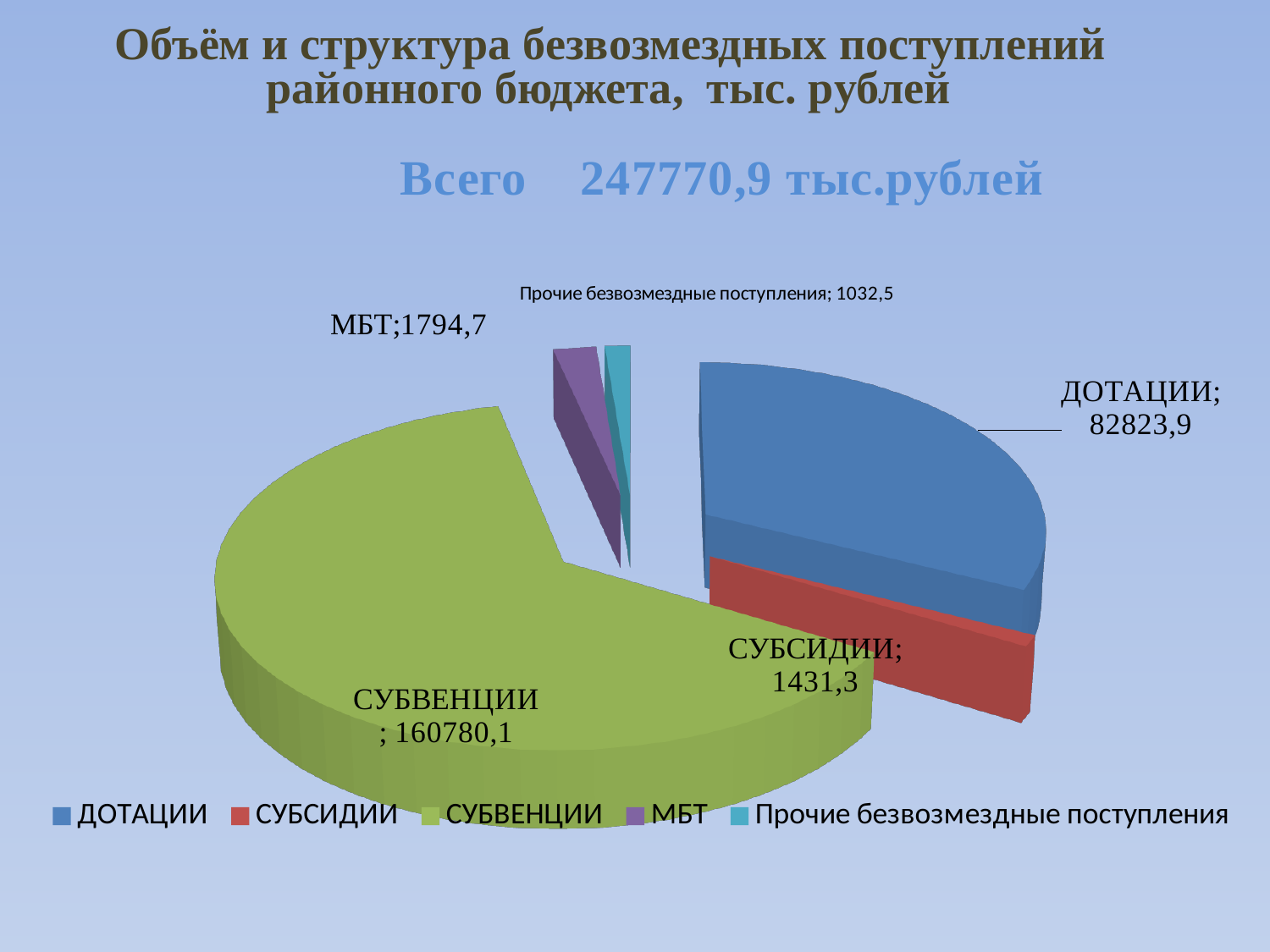
What is the value for МБТ? 1794,7 What type of chart is shown on the slide? pie chart What is the value for СУБСИДИИ? 1431,3 What is the difference between the values for СУБВЕНЦИИ and ДОТАЦИИ? 77956,2 What is the value for ДОТАЦИИ? 82823,9 Which is larger, the value for МБТ or the value for СУБСИДИИ? МБТ What is the difference between the values for МБТ and Прочие безвозмездные поступления? 762,2 What is the value for СУБВЕНЦИИ? 160780,1 How many categories does the legend list? 5 What is the value for Прочие безвозмездные поступления? 1032,5 Which category has the largest slice of the pie? СУБВЕНЦИИ